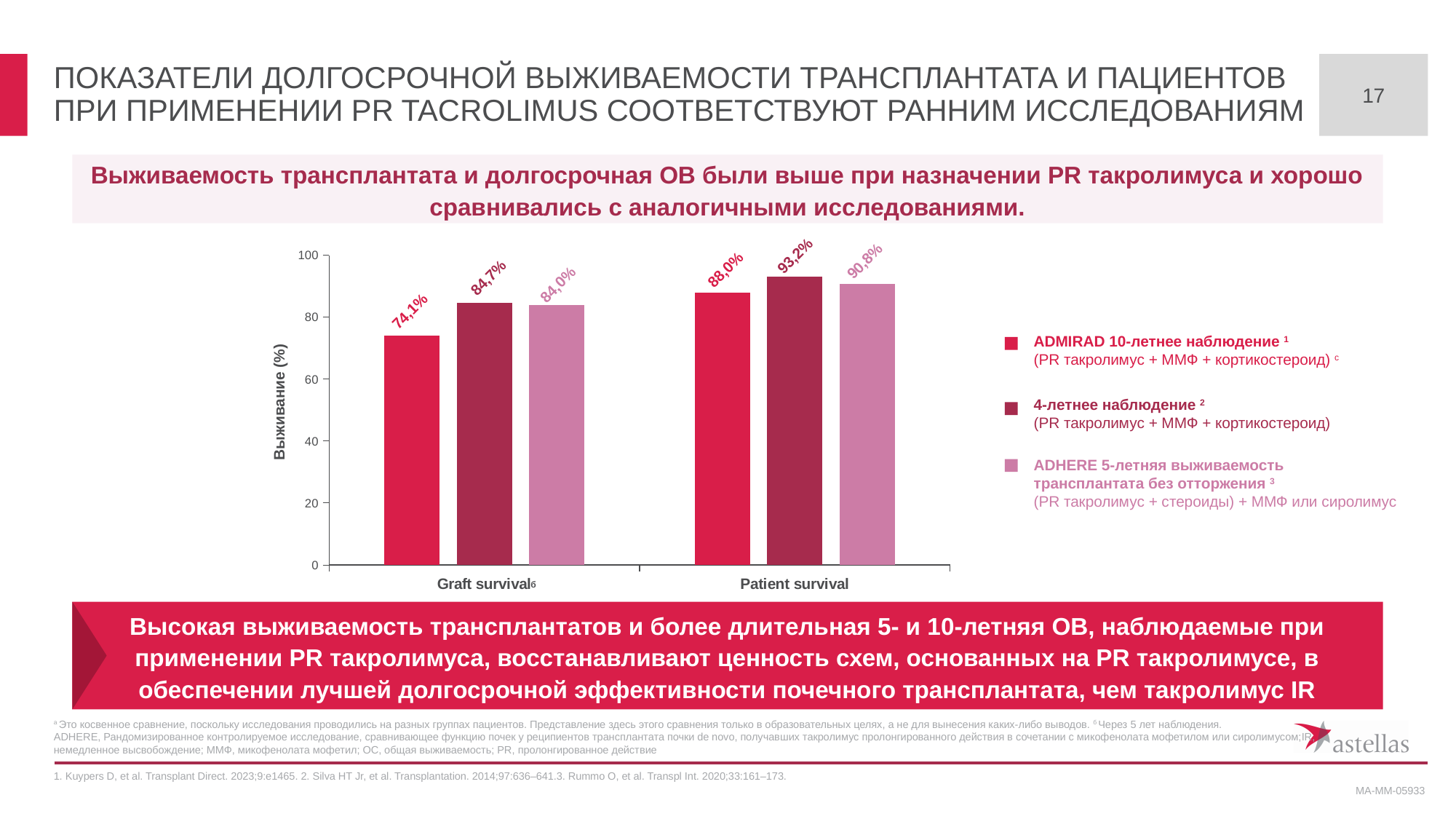
Which series has the lowest Graft survival value? ADMIRAD 10-летнее наблюдение What kind of chart is shown on the slide? Bar chart Is the Graft survival value for the ADMIRAD 10-летнее наблюдение series greater or less than 80? less How many series does the legend list? 3 How many categories are shown on the x axis? 2 What is the Patient survival value for the 4-летнее наблюдение series? 93,2% What is the Graft survival value for the ADMIRAD 10-летнее наблюдение series? 74,1% What is the Graft survival value for the ADHERE 5-летняя выживаемость трансплантата без отторжения series? 84,0% Which is larger for the 4-летнее наблюдение series: Graft survival or Patient survival? Patient survival Which series has the highest Patient survival value? 4-летнее наблюдение What is the difference between the Patient survival and Graft survival values for the ADMIRAD 10-летнее наблюдение series? 13,9% What is the Patient survival value for the ADHERE 5-летняя выживаемость трансплантата без отторжения series? 90,8%